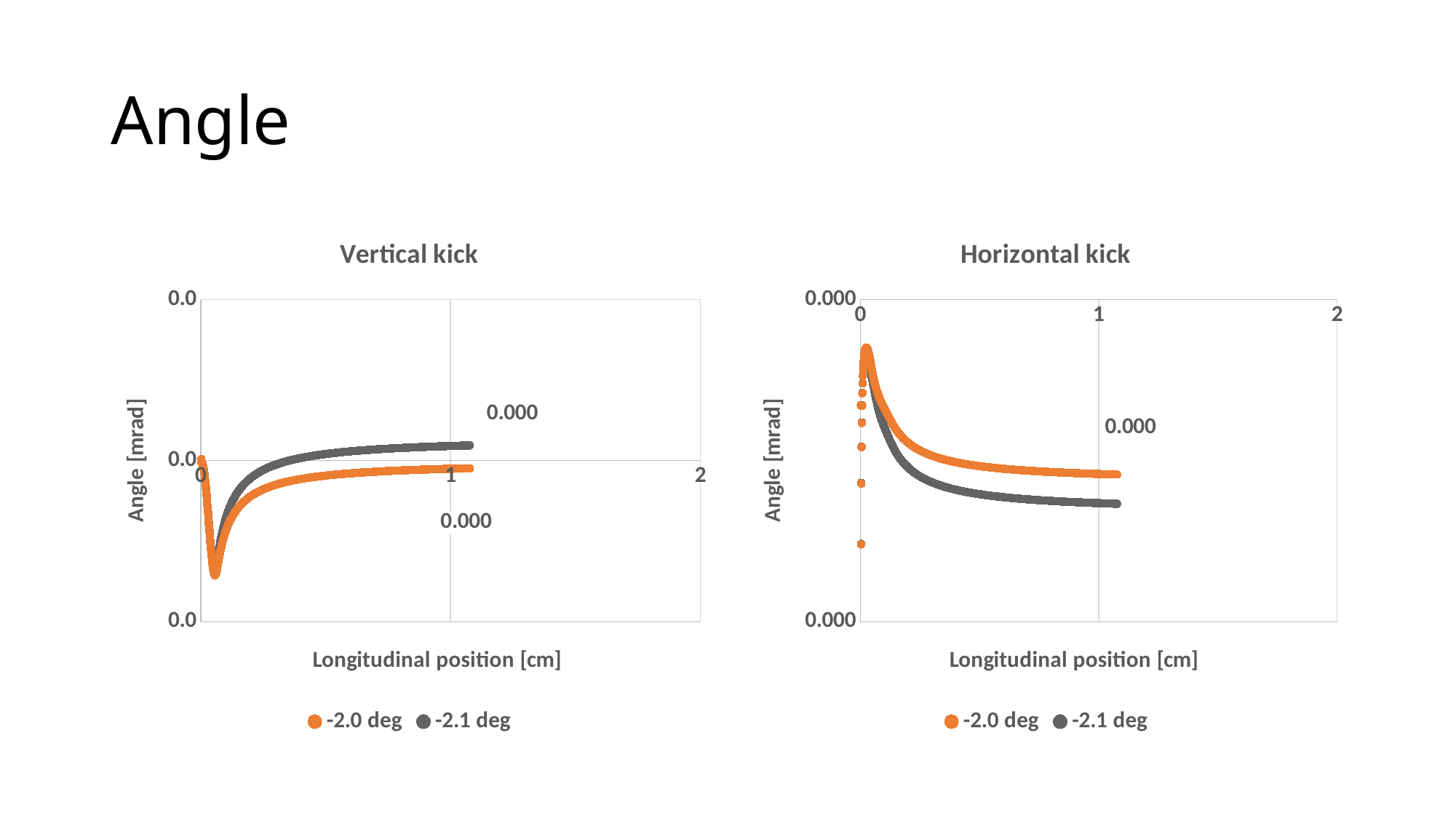
How many series does the legend of the Horizontal kick chart list? 2 What are the two legend entries of the Vertical kick chart? -2.0 deg and -2.1 deg In the Horizontal kick chart, after the initial peak near the start, do the values rise or fall as the longitudinal position increases? fall What kind of chart is the Vertical kick chart? scatter chart What is the x-axis title of the Horizontal kick chart? Longitudinal position [cm] How many series does the legend of the Vertical kick chart list? 2 In the Horizontal kick chart, which series reaches the highest point at the peak near the start? -2.0 deg In the Vertical kick chart, which series is higher at a longitudinal position of 1 cm, -2.0 deg or -2.1 deg? -2.1 deg In the Vertical kick chart, which series reaches the lowest point at the dip near the start? -2.0 deg In the Vertical kick chart, after the sharp dip near the start, do the values rise or fall as the longitudinal position increases? rise In the Horizontal kick chart, which series is higher at a longitudinal position of 1 cm, -2.0 deg or -2.1 deg? -2.0 deg